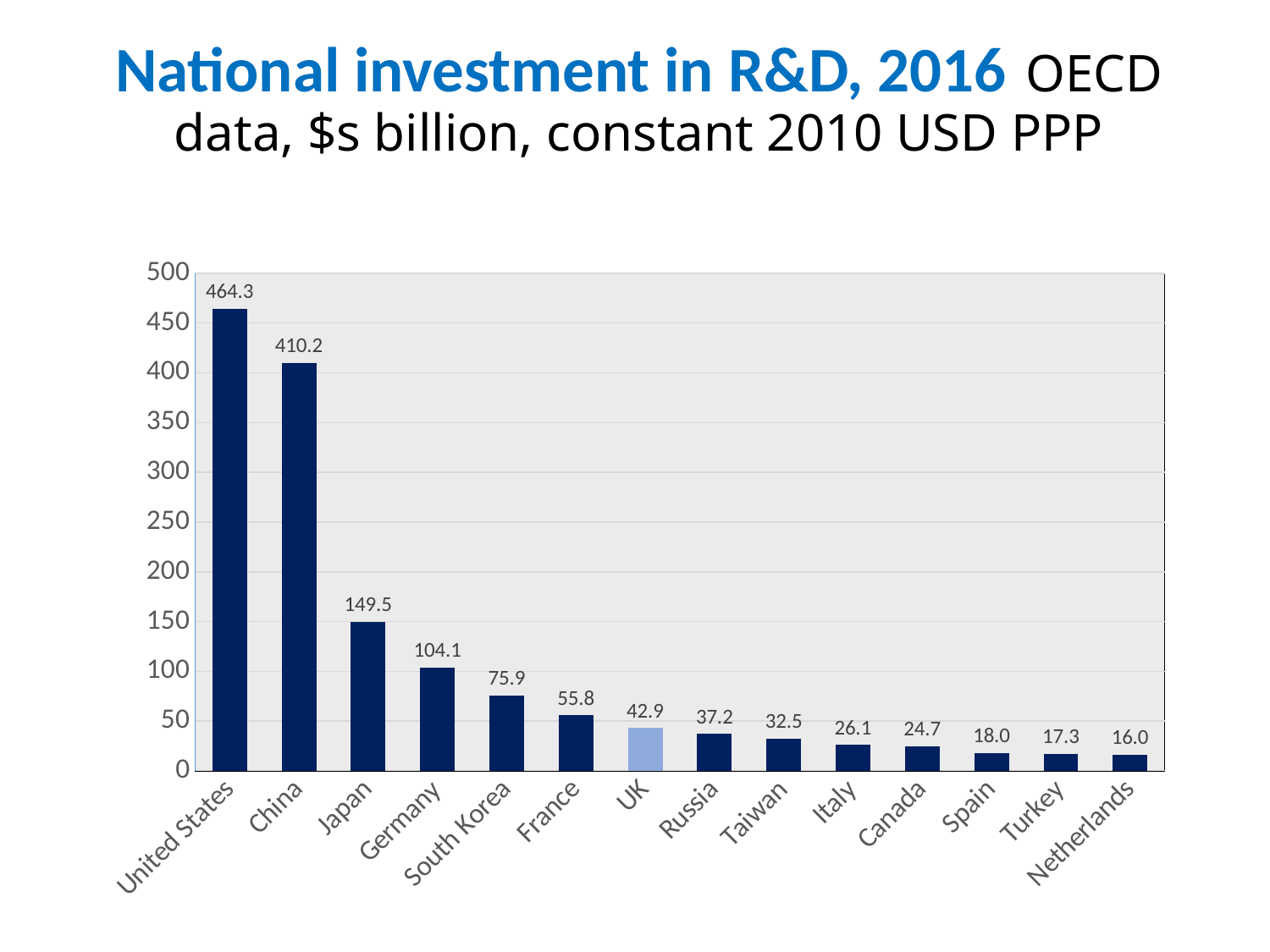
What is the difference between the values for Japan and Germany? 45.4 How many countries are shown on the chart? 14 What is the value for Netherlands? 16.0 Which country has the highest value? United States What is the difference between the values for United States and China? 54.1 What is the value for the UK? 42.9 Which is larger, the value for France or the value for Russia? France Which country's bar is shown in a lighter blue colour than the others? UK What kind of chart is this? bar chart Is the value for South Korea greater or less than 100? less Which country has the lowest value? Netherlands What is the value for Germany? 104.1